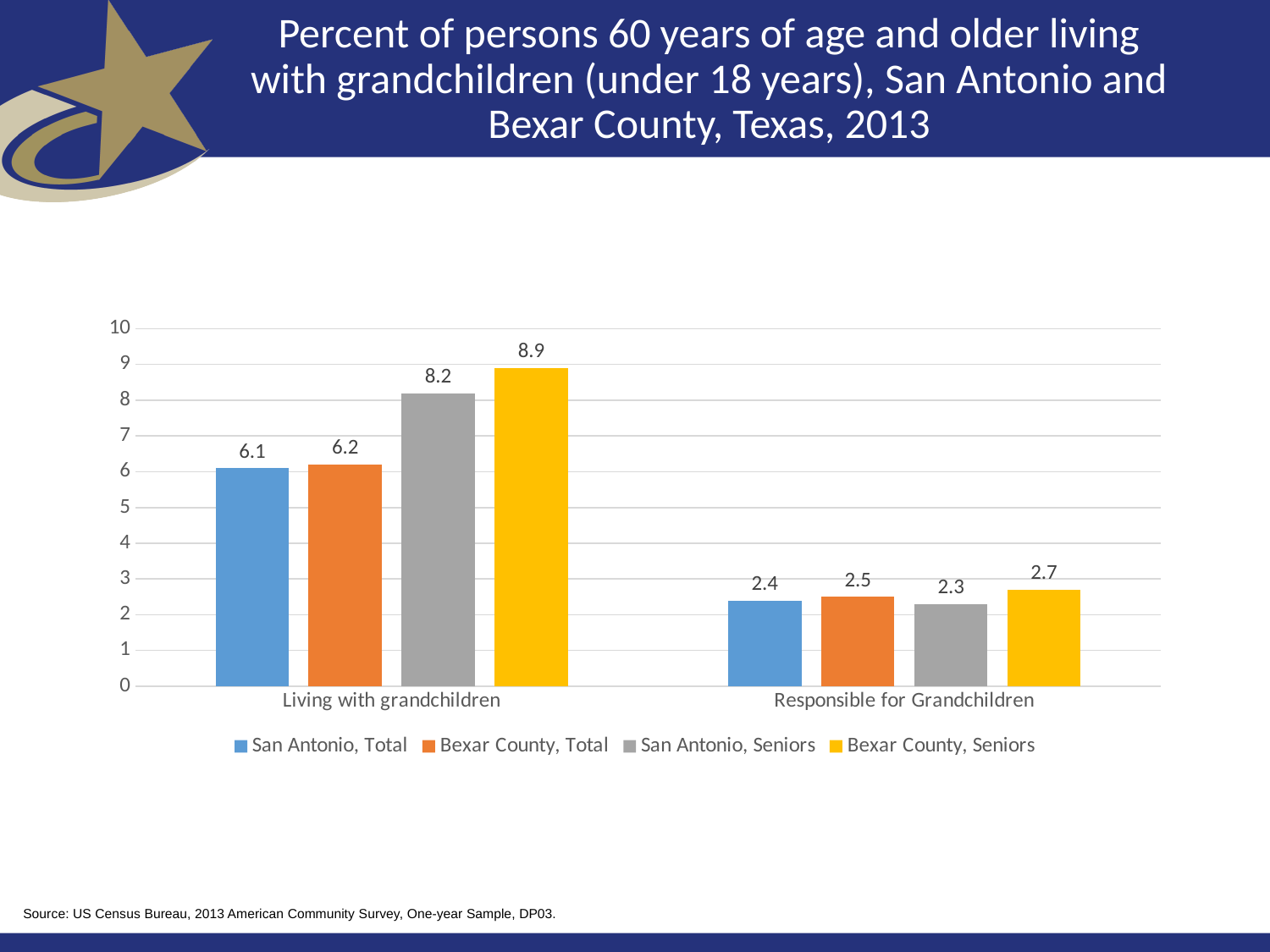
What is the value for San Antonio, Seniors in the Living with grandchildren category? 8.2 What is the difference between Bexar County, Seniors and San Antonio, Seniors in the Responsible for Grandchildren category? 0.4 What is the value for San Antonio, Total in the Responsible for Grandchildren category? 2.4 How many categories are shown on the x axis? 2 Which series has the highest value in the Living with grandchildren category? Bexar County, Seniors What is the difference between Bexar County, Seniors and San Antonio, Total in the Living with grandchildren category? 2.8 How many series does the legend list? 4 What is the value for Bexar County, Seniors in the Living with grandchildren category? 8.9 Which series has the lowest value in the Responsible for Grandchildren category? San Antonio, Seniors Which is larger: San Antonio, Seniors for Living with grandchildren or Bexar County, Total for Living with grandchildren? San Antonio, Seniors What kind of chart is shown on the slide? Bar chart What colour are the bars for Bexar County, Total? Orange